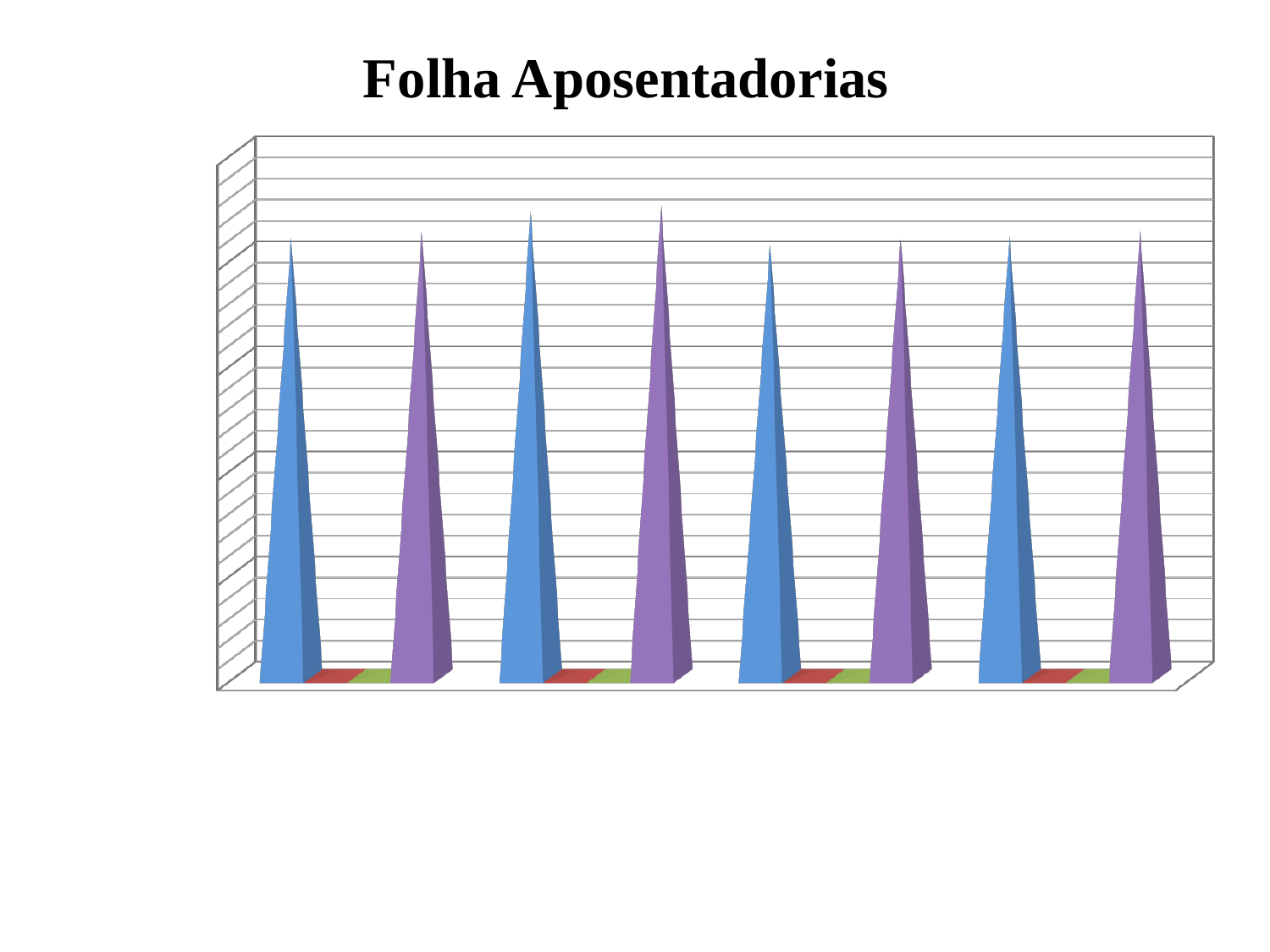
Which two bar colours are close to zero in every group? red and green Which group of bars, counted from the left, has the tallest bars? the second group How many bars are there in each group? 4 Is the blue bar in the second group from the left taller or shorter than the blue bar in the third group? taller What is the title of the chart? Folha Aposentadorias Is the purple bar in the second group from the left taller or shorter than the purple bar in the fourth group? taller How many groups of bars are plotted along the x axis? 4 What kind of chart is shown on the slide? bar chart